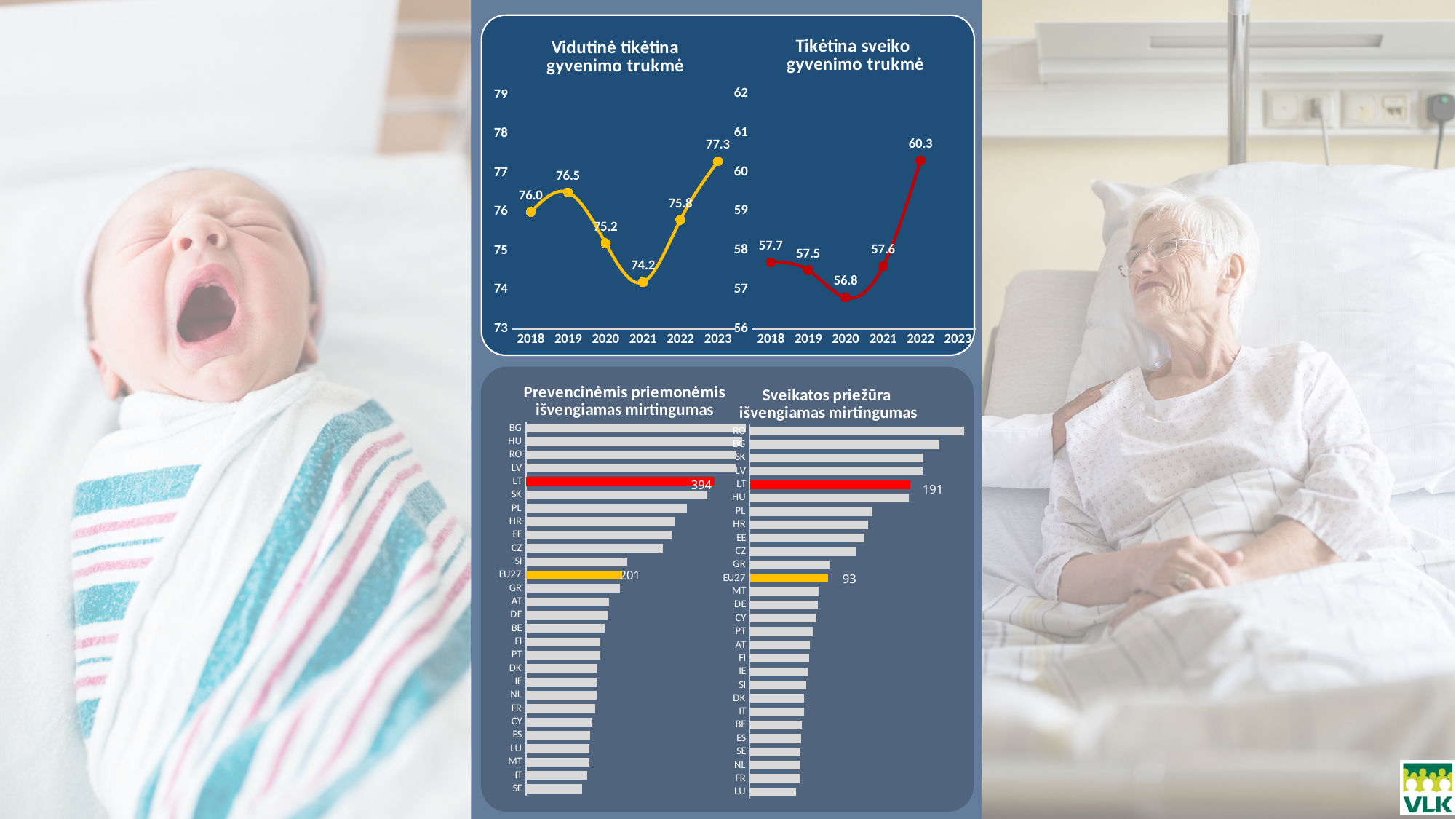
In the 'Tikėtina sveiko gyvenimo trukmė' chart, what is the value for 2020? 56.8 In the 'Sveikatos priežūra išvengiamas mirtingumas' chart, what is the value for EU27? 93 What kind of chart is 'Sveikatos priežūra išvengiamas mirtingumas'? bar chart In the 'Prevencinėmis priemonėmis išvengiamas mirtingumas' chart, what is the difference between the LT value and the EU27 value? 193 What kind of chart is 'Tikėtina sveiko gyvenimo trukmė'? line chart In the 'Vidutinė tikėtina gyvenimo trukmė' chart, how many data points are plotted? 6 In the 'Tikėtina sveiko gyvenimo trukmė' chart, is the value for 2018 larger or smaller than the value for 2019? larger In the 'Vidutinė tikėtina gyvenimo trukmė' chart, what is the difference between the 2023 value and the 2021 value? 3.1 In the 'Tikėtina sveiko gyvenimo trukmė' chart, which year has the highest value? 2022 In the 'Vidutinė tikėtina gyvenimo trukmė' chart, what is the value for 2023? 77.3 In the 'Prevencinėmis priemonėmis išvengiamas mirtingumas' chart, what is the value for LT? 394 In the 'Vidutinė tikėtina gyvenimo trukmė' chart, which year has the lowest value? 2021